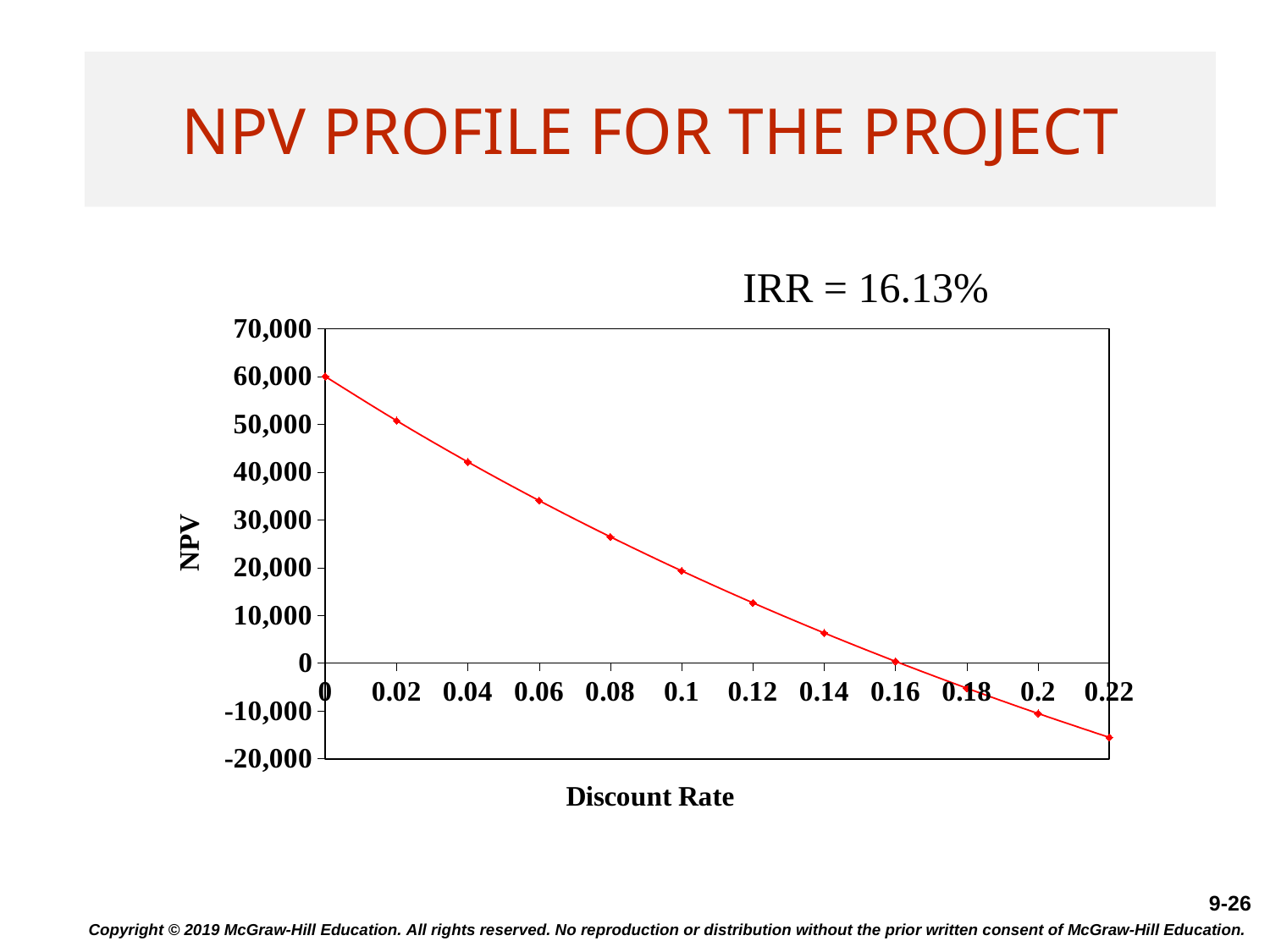
Is the NPV at a discount rate of 0.14 greater or less than 10,000? less Is the NPV at a discount rate of 0.08 greater or less than 30,000? less At which discount rate is NPV highest? 0 Which has the larger NPV: a discount rate of 0.04 or 0.12? 0.04 What kind of chart is shown on the slide? line chart Is the NPV at a discount rate of 0.04 greater or less than 40,000? greater Does NPV rise or fall as the discount rate increases along the x axis? fall How many data points are plotted on the NPV profile line? 12 At which discount rate is NPV lowest? 0.22 What IRR value is annotated on the chart? 16.13% What is the title of the x axis? Discount Rate